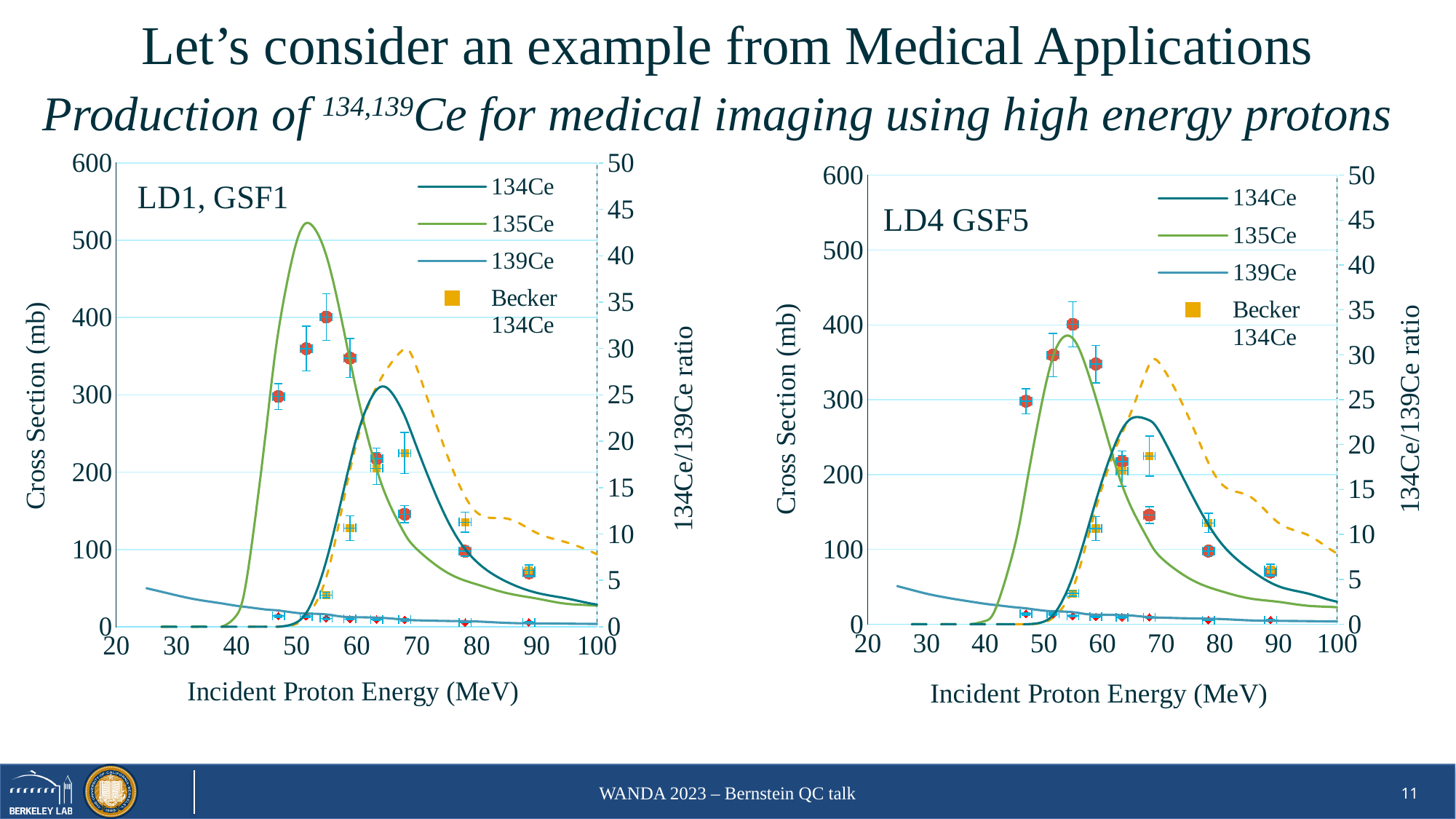
How many series does the legend of the right chart (LD4 GSF5) list? 4 In the left chart (LD1, GSF1), does the 139Ce curve rise or fall as incident proton energy increases? fall In the left chart (LD1, GSF1), is the peak cross section of the 135Ce curve greater or less than 500? greater In the right chart (LD4 GSF5), is the peak cross section of the 135Ce curve greater or less than 400? less What kind of chart is the left chart labelled LD1, GSF1? line chart In the right chart (LD4 GSF5), which of the three calculated curves has the lowest cross section at 60 MeV? 139Ce In the right chart (LD4 GSF5), which of the three calculated curves reaches the highest cross section? 135Ce What is the label of the x axis on the left chart (LD1, GSF1)? Incident Proton Energy (MeV) What is the label of the right-hand y axis on the right chart (LD4 GSF5)? 134Ce/139Ce ratio In the left chart (LD1, GSF1), which curve reaches the highest cross section, 134Ce or 135Ce? 135Ce In the right chart (LD4 GSF5), is the peak cross section of the 134Ce curve greater or less than 300? less